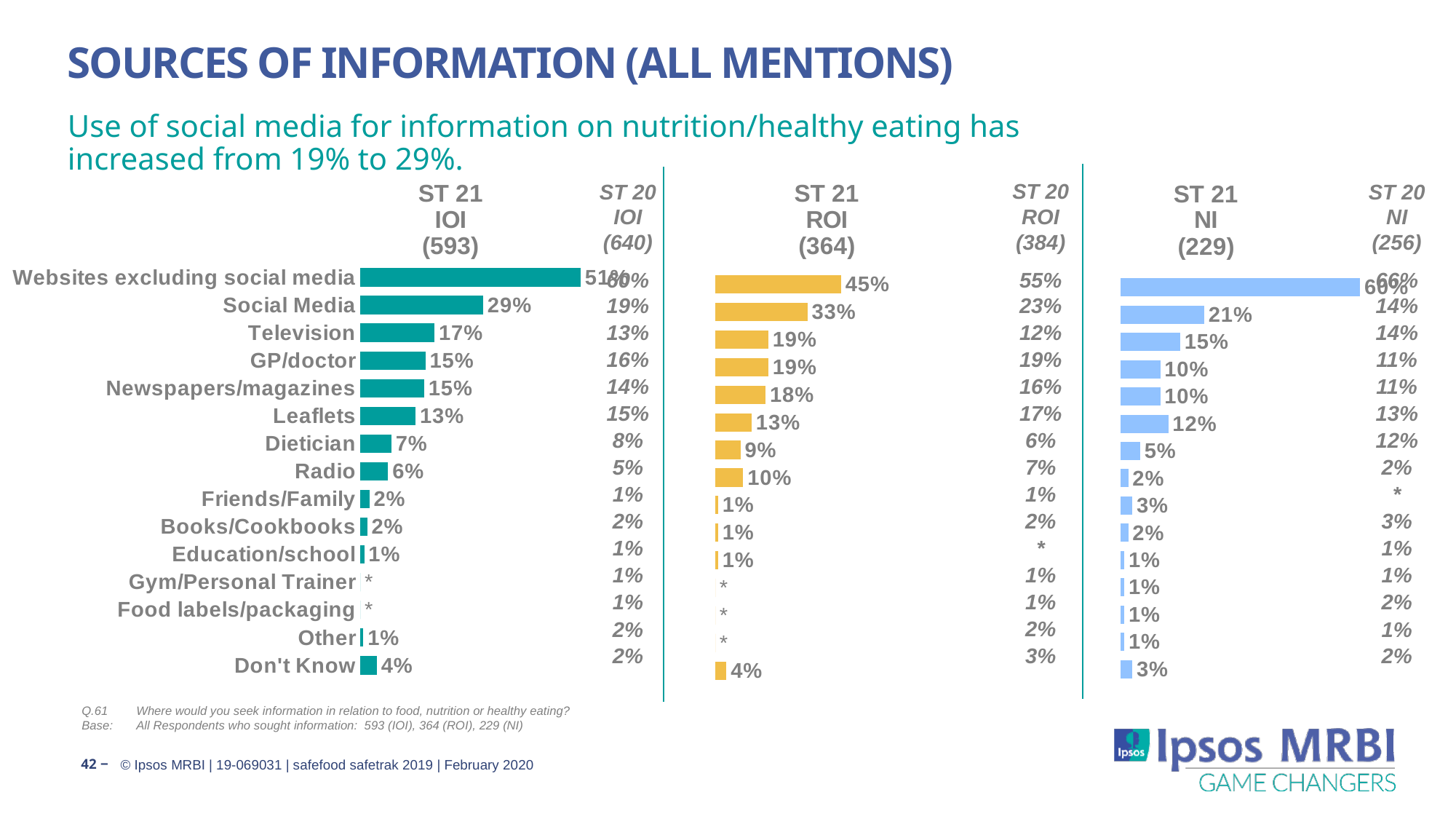
In the ST 21 ROI chart, what is the difference between Websites excluding social media and Social Media? 12% In the ST 21 IOI chart, what is the value for Television? 17% In the ST 21 ROI chart, what is the value for Don't Know? 4% What colour are the bars in the ST 21 ROI chart? Yellow In the ST 21 IOI chart, what is the difference between Social Media and Television? 12% In the ST 21 IOI chart, which category has the highest value? Websites excluding social media In the ST 21 ROI chart, what is the value for Websites excluding social media? 45% How many categories are listed in the ST 21 IOI chart? 15 In the ST 21 NI chart, what is the value for Social Media? 21% In the ST 21 NI chart, which is larger, Television or Leaflets? Television What kind of chart is the ST 21 ROI chart? Bar chart In the ST 21 IOI chart, what is the value for Social Media? 29%